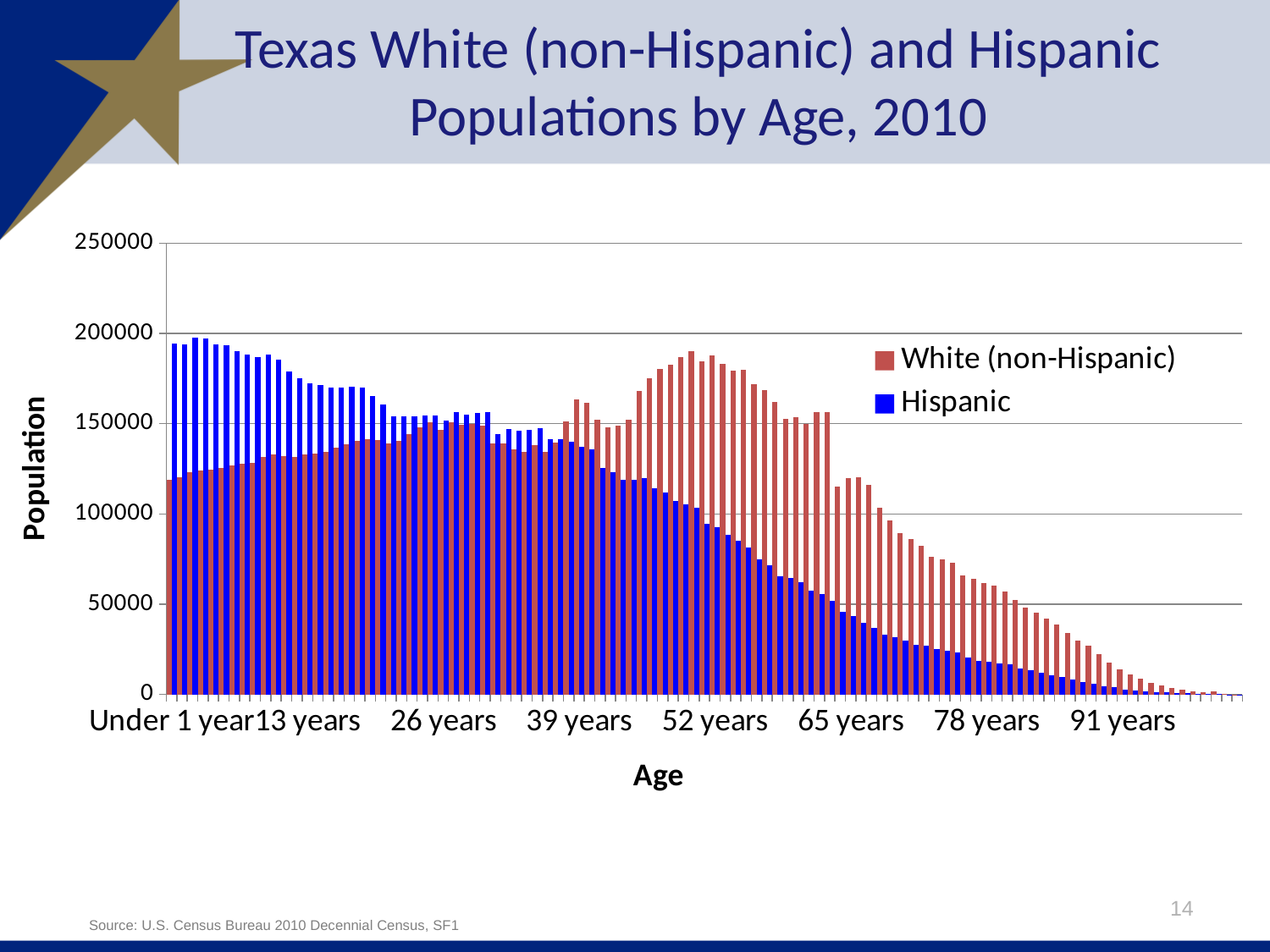
Do the Hispanic values generally rise or fall as age increases along the x axis? fall What kind of chart is shown on the slide? bar chart Is the White (non-Hispanic) value for 52 years greater or less than 150000? greater Is the White (non-Hispanic) value for Under 1 year greater or less than 150000? less At 52 years, which series has the larger value, White (non-Hispanic) or Hispanic? White (non-Hispanic) Is the Hispanic value for Under 1 year greater or less than 150000? greater What is the label on the vertical axis? Population What are the two series named in the legend? White (non-Hispanic) and Hispanic How many series does the legend list? 2 At Under 1 year, which series has the larger value, White (non-Hispanic) or Hispanic? Hispanic